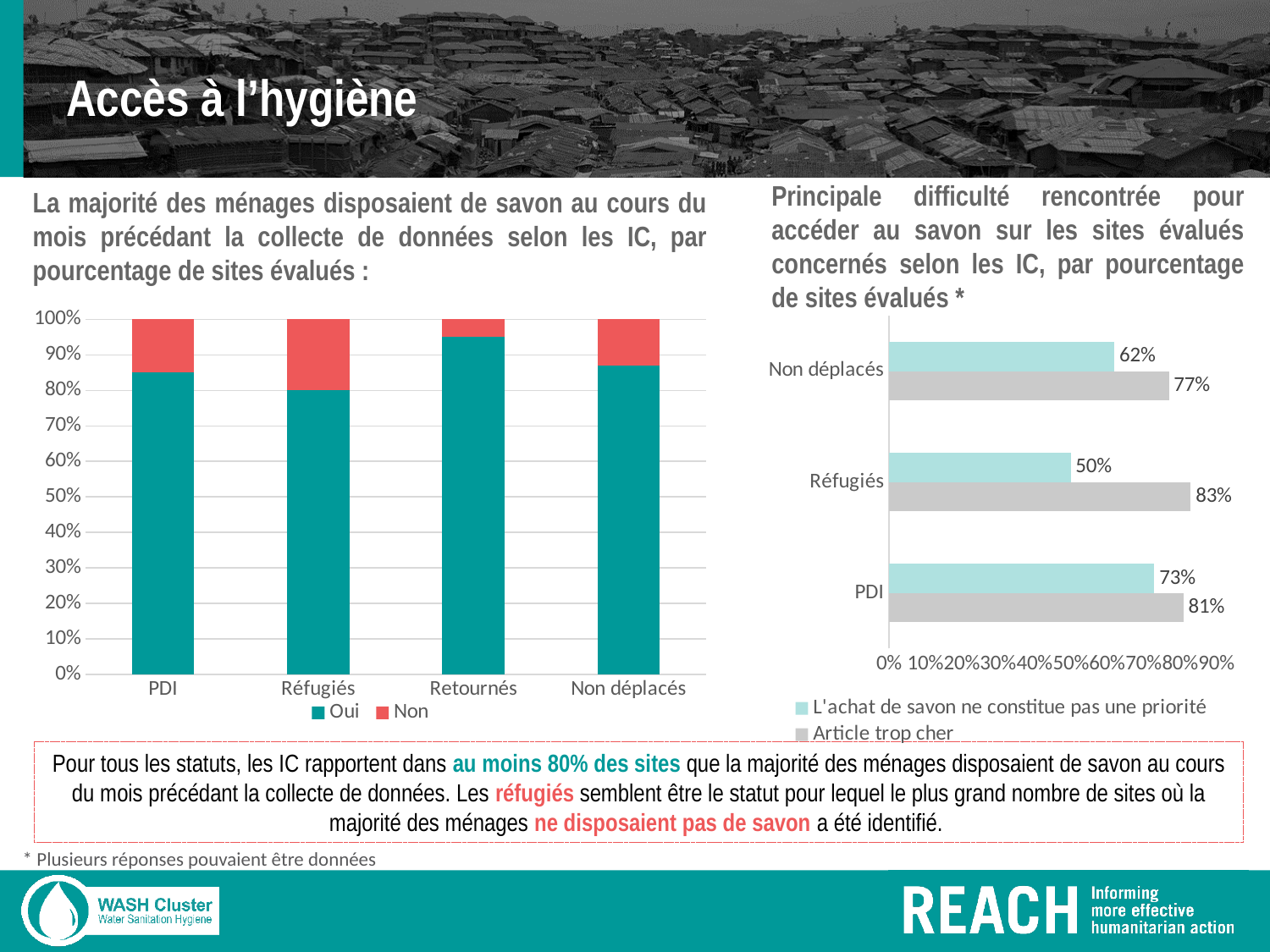
In the left chart, is the 'Oui' value for Retournés greater or less than 90%? greater In the right chart, what is the difference between 'Article trop cher' and 'L'achat de savon ne constitue pas une priorité' for Réfugiés? 33% In the right chart (Principale difficulté rencontrée pour accéder au savon), what percentage of sites for Réfugiés reported 'Article trop cher'? 83% In the right chart, what is the value for 'L'achat de savon ne constitue pas une priorité' for PDI? 73% In the right chart, what is the value for 'L'achat de savon ne constitue pas une priorité' for Non déplacés? 62% In the right chart, which group has the lowest value for 'L'achat de savon ne constitue pas une priorité'? Réfugiés How many categories are shown on the x axis of the left chart (La majorité des ménages disposaient de savon)? 4 In the right chart, which group has the highest value for 'Article trop cher'? Réfugiés How many series does the legend of the right chart list? 2 What kind of chart is the left chart (La majorité des ménages disposaient de savon)? Stacked bar chart In the right chart, which is larger for PDI: 'Article trop cher' or 'L'achat de savon ne constitue pas une priorité'? Article trop cher In the left chart, is the 'Oui' value for Réfugiés greater or less than 90%? less